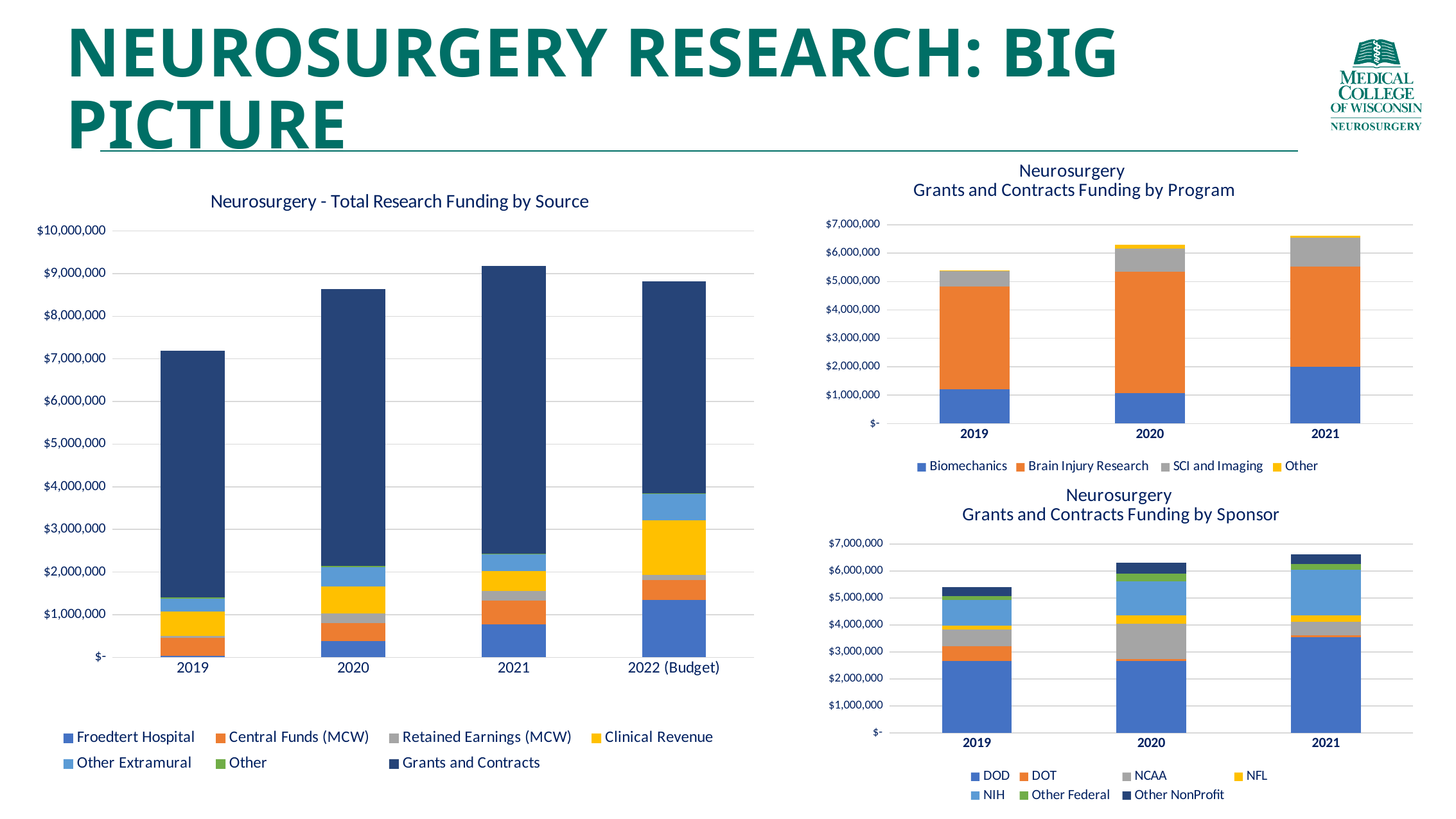
In the 'Neurosurgery - Total Research Funding by Source' chart, which year has the highest total funding? 2021 In the 'Neurosurgery Grants and Contracts Funding by Sponsor' chart, how many years are plotted? 3 In the 'Neurosurgery - Total Research Funding by Source' chart, which year has the lowest total funding? 2019 In the 'Neurosurgery Grants and Contracts Funding by Program' chart, do the total bar heights rise or fall from 2019 to 2021? rise In the 'Neurosurgery - Total Research Funding by Source' chart, what kind of chart is shown? Stacked bar chart In the 'Neurosurgery Grants and Contracts Funding by Program' chart, is the total for 2019 greater or less than $6,000,000? less In the 'Neurosurgery - Total Research Funding by Source' chart, is the total for 2019 greater or less than $8,000,000? less In the 'Neurosurgery Grants and Contracts Funding by Program' chart, how many programs does the legend list? 4 In the 'Neurosurgery Grants and Contracts Funding by Sponsor' chart, which year has the highest total funding? 2021 In the 'Neurosurgery - Total Research Funding by Source' chart, how many years (categories) are plotted? 4 In the 'Neurosurgery - Total Research Funding by Source' chart, is the total for 2021 greater or less than $9,000,000? greater In the 'Neurosurgery - Total Research Funding by Source' chart, how many funding sources does the legend list? 7